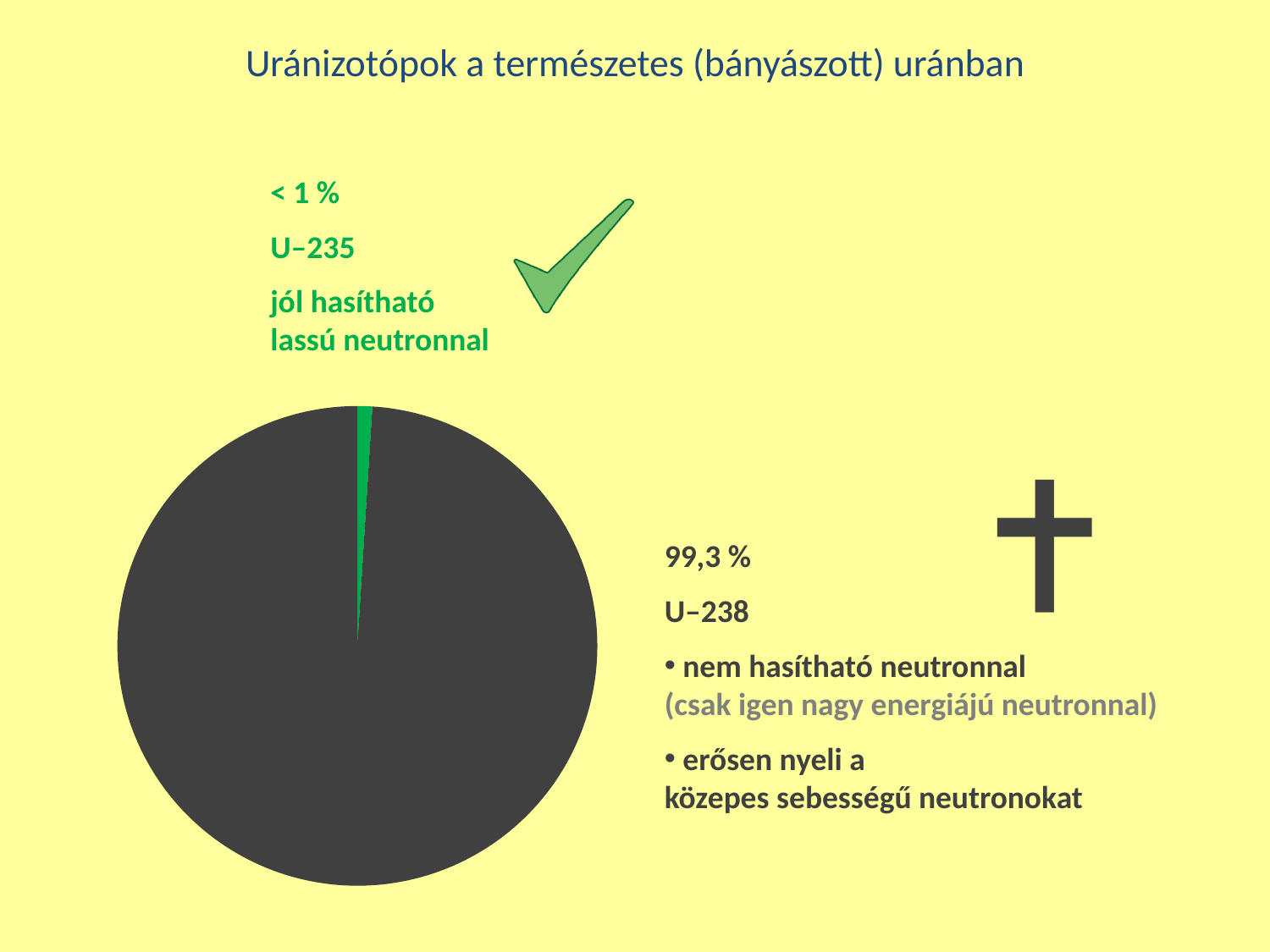
Which slice is larger, U–235 or U–238? U–238 What label is printed for the share of U–235 in the pie chart? < 1 % What share of the pie does U–238 take? 99,3 % What colour is the U–235 slice in the pie chart? green What percentage is shown for U–238 in the pie chart? 99,3 % Which isotope has the smallest slice in the pie chart? U–235 Is the share of U–238 greater or less than 50 %? greater Which isotope has the largest slice in the pie chart? U–238 What kind of chart is shown on the slide? pie chart How many slices does the pie chart have? 2 What is the title of the slide containing the pie chart? Uránizotópok a természetes (bányászott) uránban